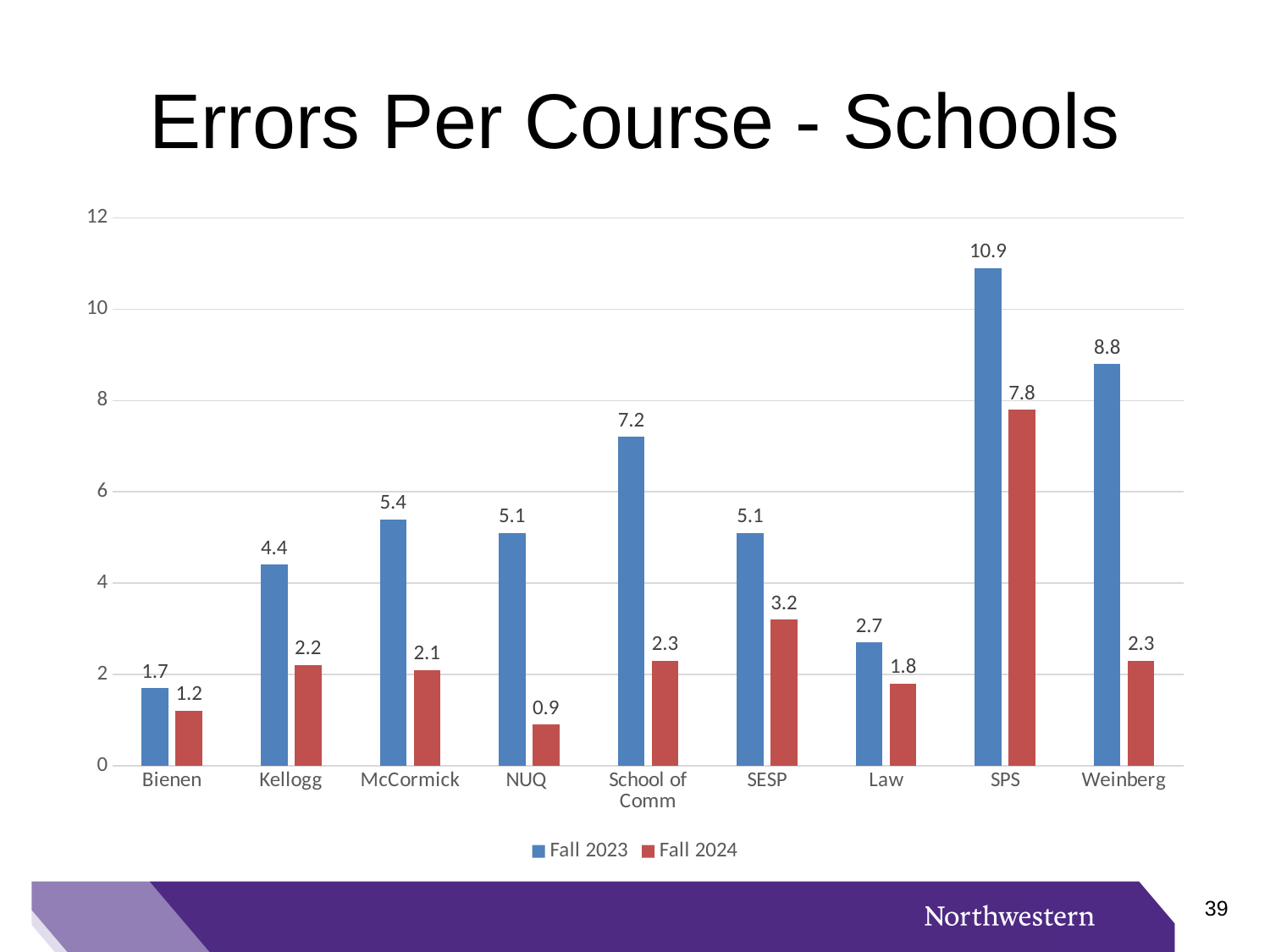
What is the difference between the Fall 2023 and Fall 2024 values for Weinberg? 6.5 What is the Fall 2023 value for SPS? 10.9 What is the Fall 2024 value for SESP? 3.2 What is the Fall 2024 value for NUQ? 0.9 How many schools are shown on the x axis? 9 Is the Fall 2023 value for School of Comm greater or less than 6? greater What kind of chart is shown on the slide? Bar chart How many series does the legend list? 2 Which school has the lowest Fall 2024 value? NUQ What is the title of the chart? Errors Per Course - Schools Which is larger for Kellogg: the Fall 2023 value or the Fall 2024 value? Fall 2023 Which school has the highest Fall 2023 value? SPS